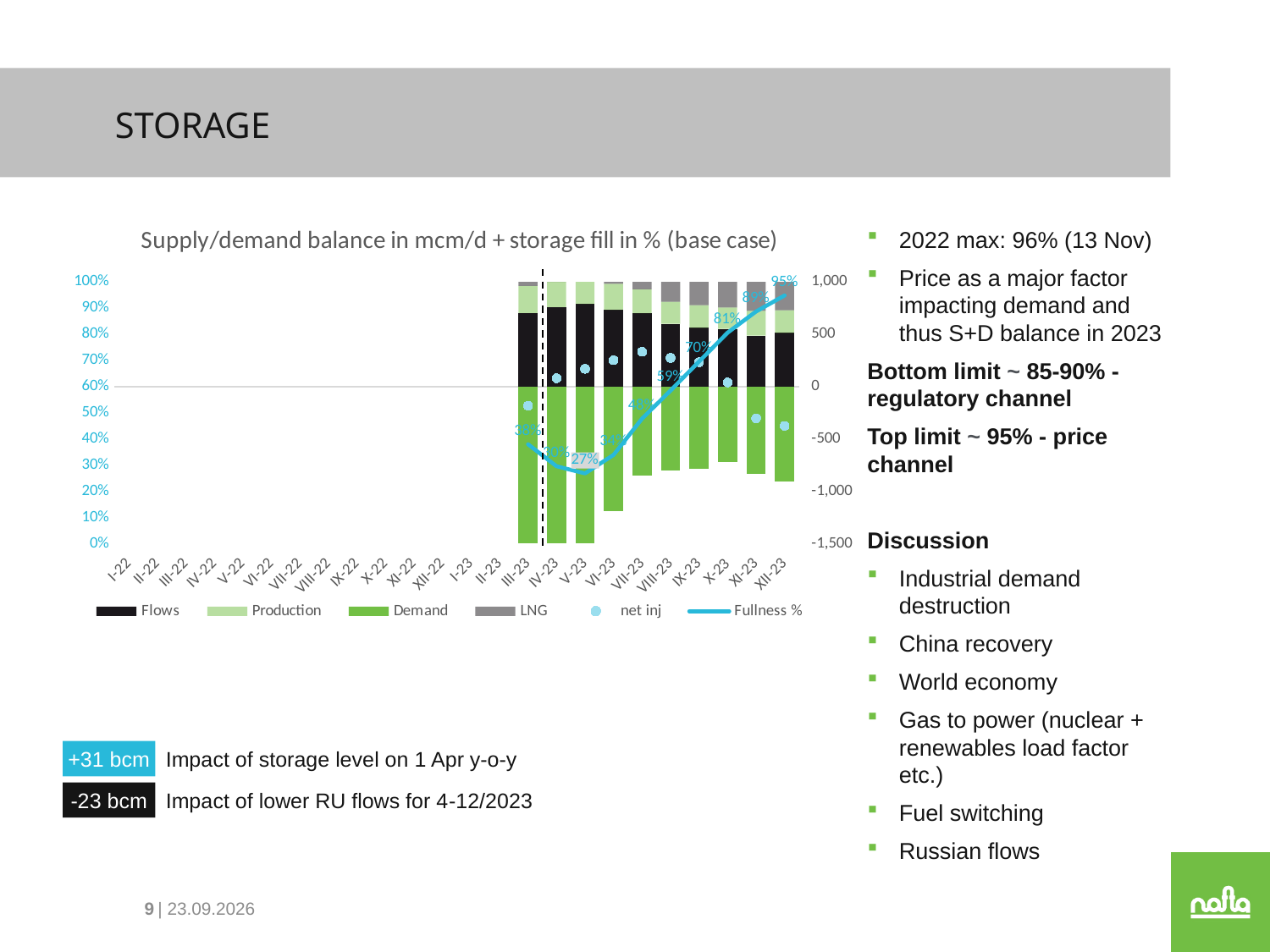
How many series does the chart legend list? 6 What is the Fullness % value shown for VIII-23? 59% What is the Fullness % value shown for V-23? 27% Does the Fullness % line rise or fall from V-23 to XII-23? Rise What is the difference between the Fullness % at XII-23 and at V-23? 68 percentage points What kind of chart is shown on the slide? A bar chart with a line Which has a higher Fullness % value, IX-23 or VI-23? IX-23 What is the Fullness % value shown for XII-23? 95% How many categories are shown on the x axis of the chart? 24 What is the title of the chart? Supply/demand balance in mcm/d + storage fill in % (base case) Which month has the highest labelled Fullness % value? XII-23 Which month has the lowest labelled Fullness % value? V-23